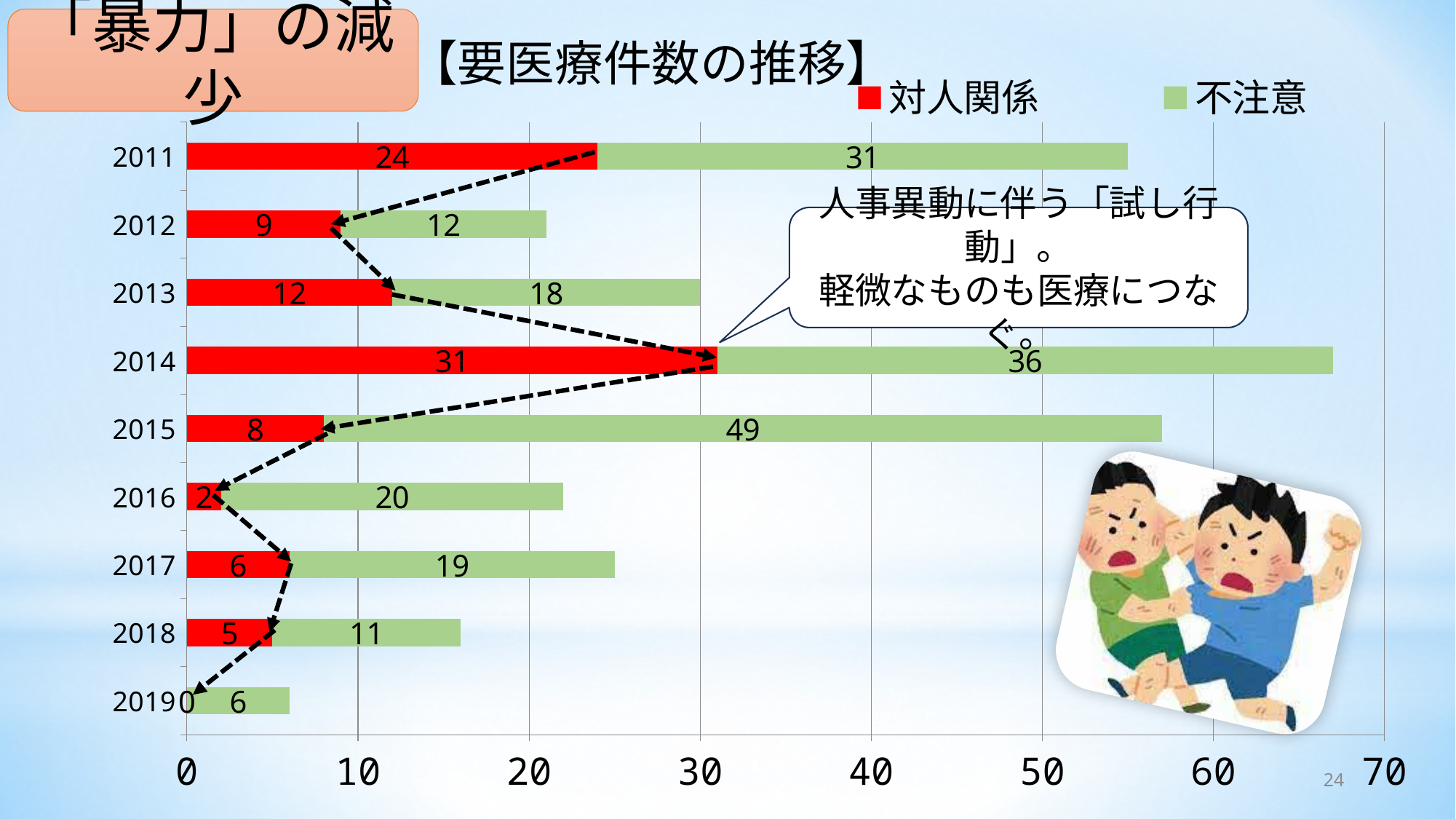
What is the value of 対人関係 for 2014? 31 How many years are shown on the chart? 9 What is the value of 不注意 for 2015? 49 What is the difference between the 対人関係 values for 2011 and 2012? 15 Which series is shown in red in the legend? 対人関係 What is the total of the stacked bar for 2014? 67 What is the value of 対人関係 for 2019? 0 Which year has the highest value for 不注意? 2015 Which is larger, the 不注意 value for 2016 or for 2017? 2016 What kind of chart is shown on the slide? stacked bar chart Which year has the lowest value for 対人関係? 2019 How many series does the legend list? 2